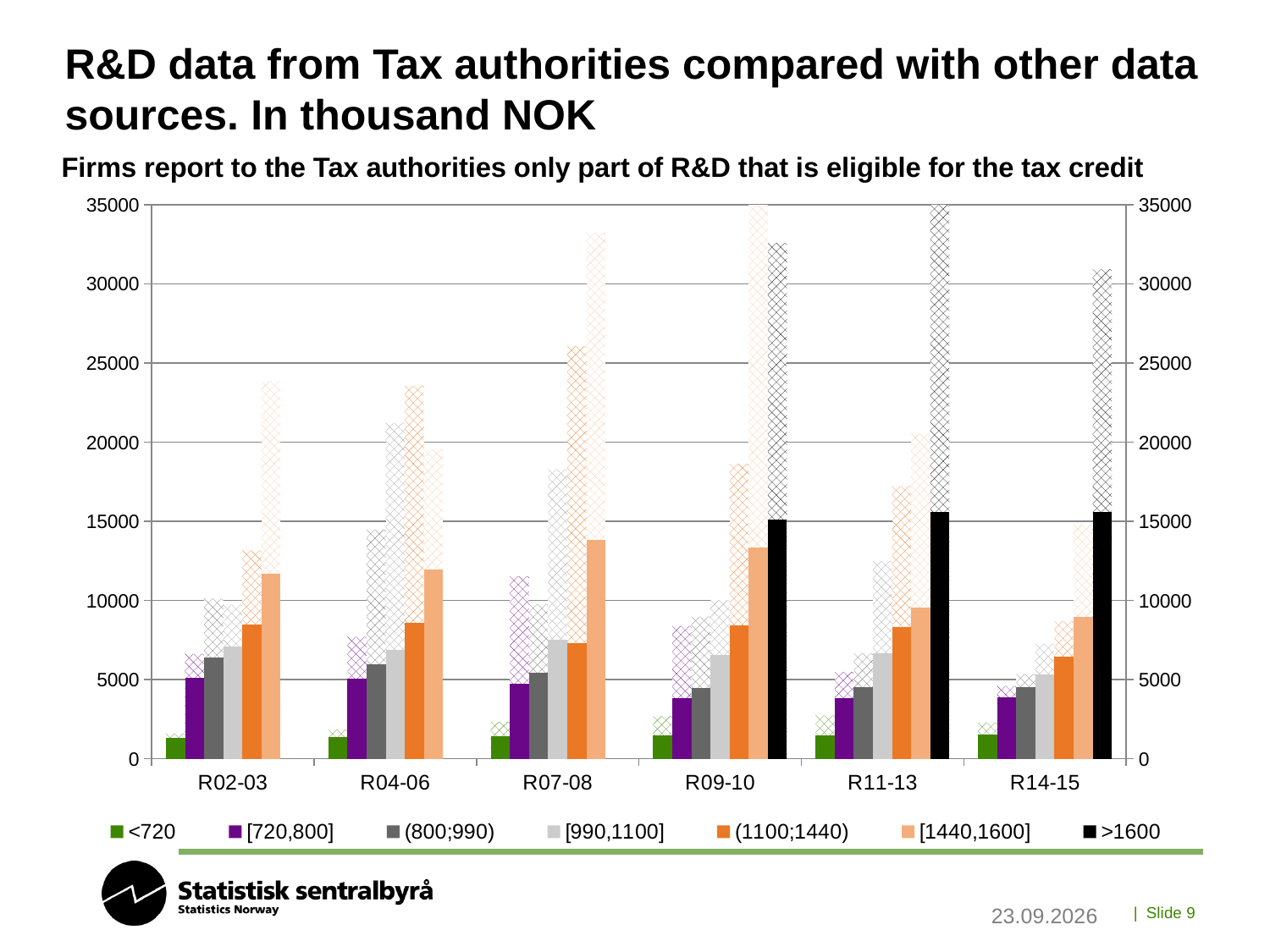
Is the value of the solid >1600 bar for R09-10 greater or less than 10000? greater Which is larger, the solid (1100;1440) bar for R04-06 or for R14-15? R04-06 Is the value of the solid (1100;1440) bar for R07-08 greater or less than 10000? less What is the title of the chart on the slide? R&D data from Tax authorities compared with other data sources. In thousand NOK How many categories are shown on the x axis? 6 Which legend entry is shown in black? >1600 What kind of chart is shown on the slide? bar chart Is the value of the solid <720 bar for R02-03 greater or less than 5000? less How many series does the legend list? 7 Which is larger, the solid [1440,1600] bar for R02-03 or for R14-15? R02-03